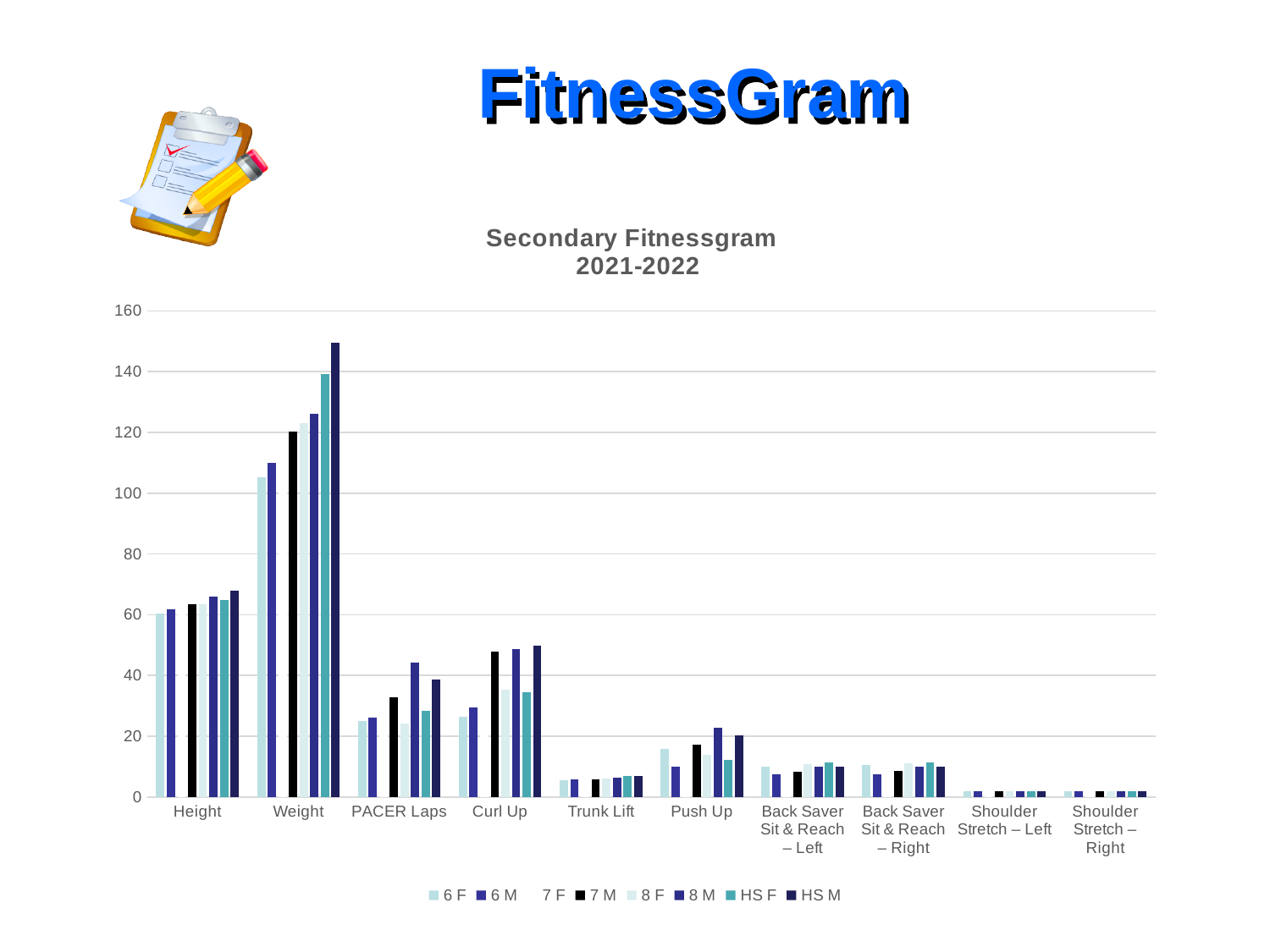
Is the HS M value for Weight greater or less than 140? greater What is the title of the chart? Secondary Fitnessgram 2021-2022 How many categories are shown along the x axis of the chart? 10 Is the HS M value for Curl Up greater or less than 40? greater For Weight, which is larger: the HS M value or the 6 F value? HS M Is the 6 F value for Weight greater or less than 100? greater Within the Weight category, which series has the lowest value? 6 F For Push Up, which is larger: the 8 M value or the 6 M value? 8 M Which category has the highest value for the HS M series? Weight What kind of chart is shown on the slide? bar chart How many series does the chart's legend list? 8